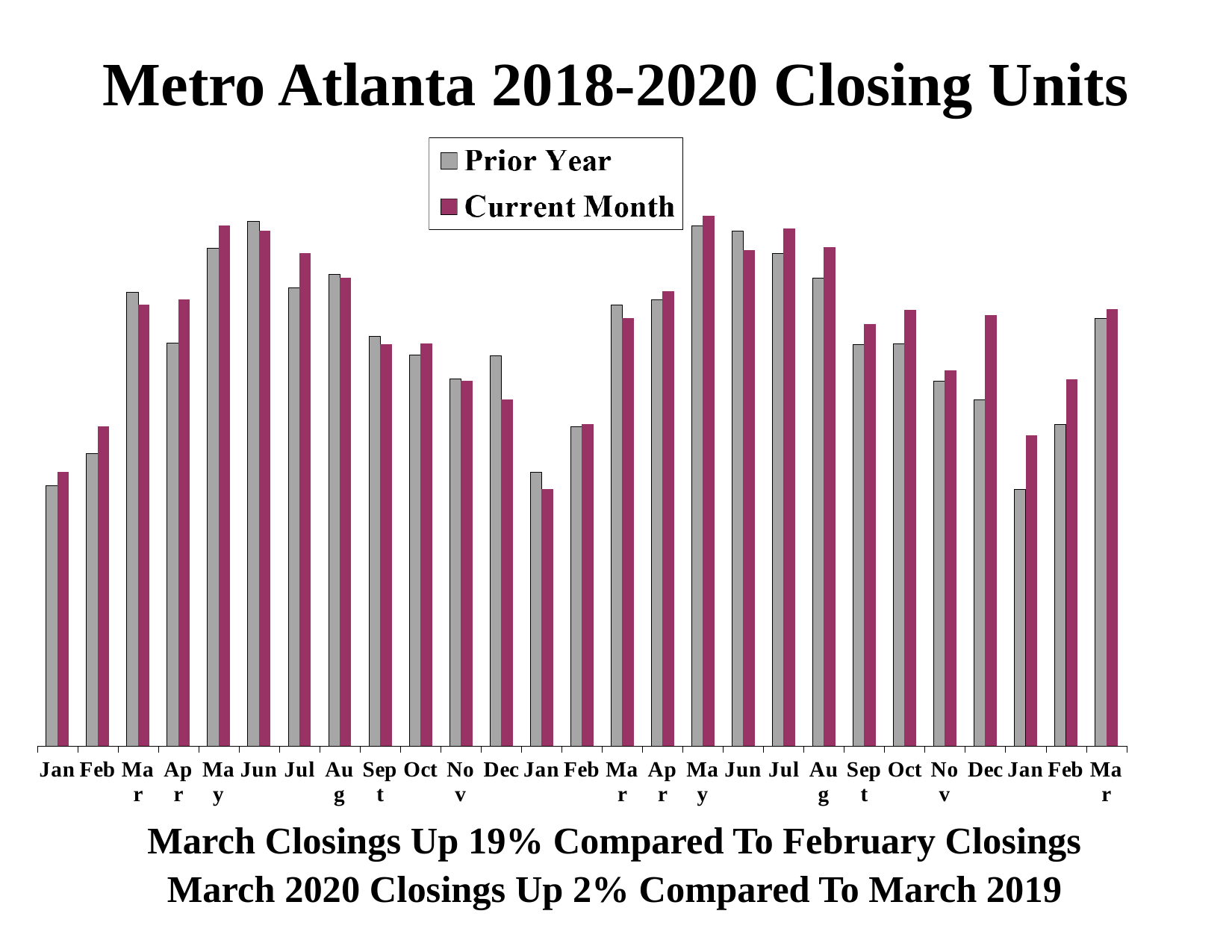
How many series does the legend list? 2 What are the two series named in the legend? Prior Year and Current Month Do the Current Month bars rise or fall from the first Jan to the first Jun on the x axis? Rise In the second Dec on the x axis, which is taller: the Prior Year bar or the Current Month bar? Current Month What kind of chart is shown on the slide? Bar chart Which month has the shortest Current Month bar? Jan (second year) What is the title of the chart? Metro Atlanta 2018-2020 Closing Units Which month has the tallest Current Month bar? May (second year) Do the Current Month bars rise or fall from the first Jun to the first Nov on the x axis? Fall In the last Jan on the x axis, which is taller: the Prior Year bar or the Current Month bar? Current Month In the first Dec on the x axis, which is taller: the Prior Year bar or the Current Month bar? Prior Year How many month categories are shown along the x axis? 27